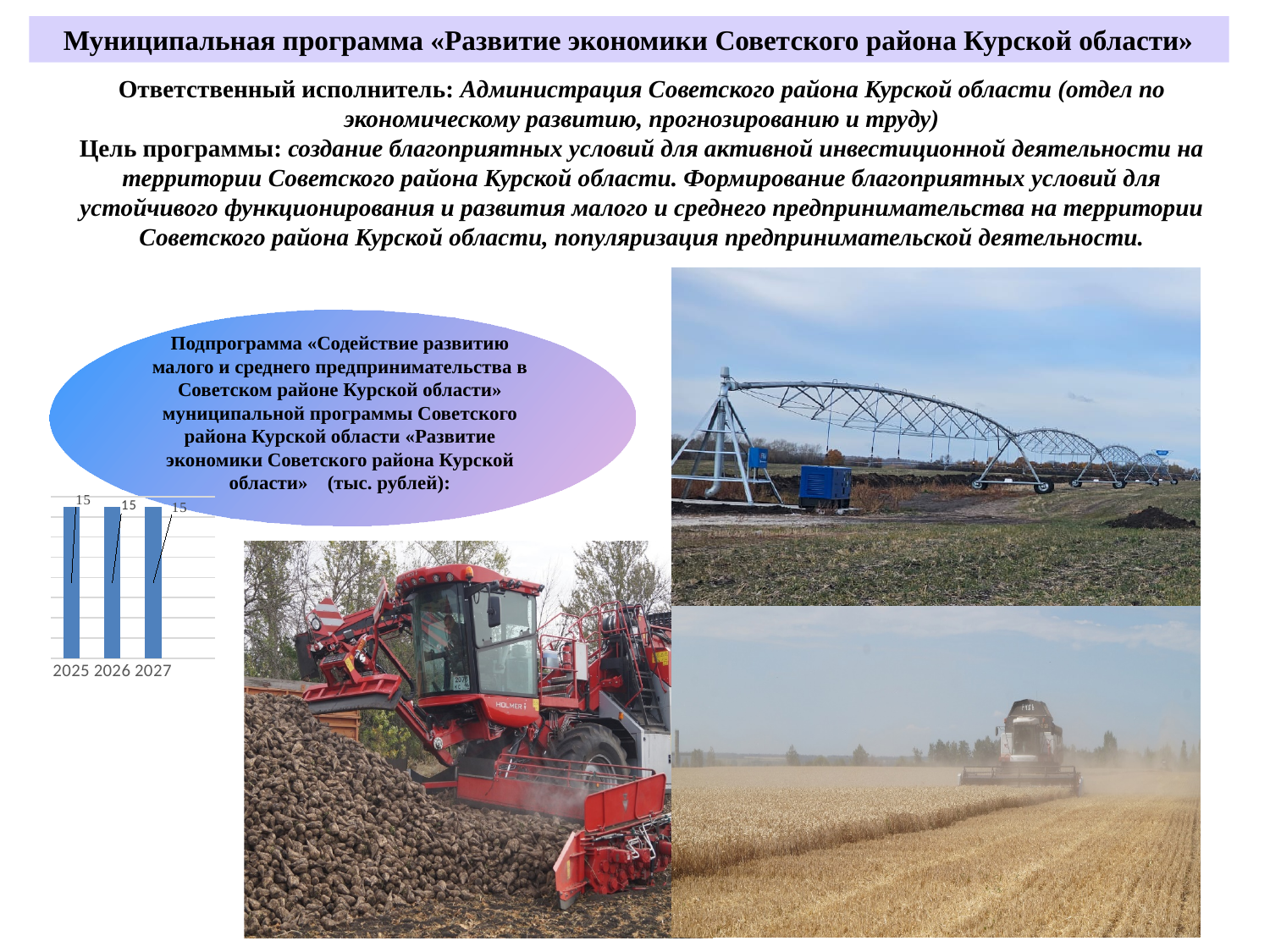
What is the value for 2027 in the bar chart? 15 What is the total of the values for 2025, 2026 and 2027 in the bar chart? 45 How many years (categories) are shown on the x axis of the bar chart? 3 What is the value for 2026 in the bar chart? 15 Do the values in the bar chart rise, fall or stay the same from 2025 to 2027? stay the same What is the difference between the values for 2027 and 2025 in the bar chart? 0 What is the value for 2025 in the bar chart? 15 What kind of chart is shown on the slide? bar chart In what units are the values of the bar chart given, according to the text above it? тыс. рублей Which years are listed on the x axis of the bar chart? 2025, 2026, 2027